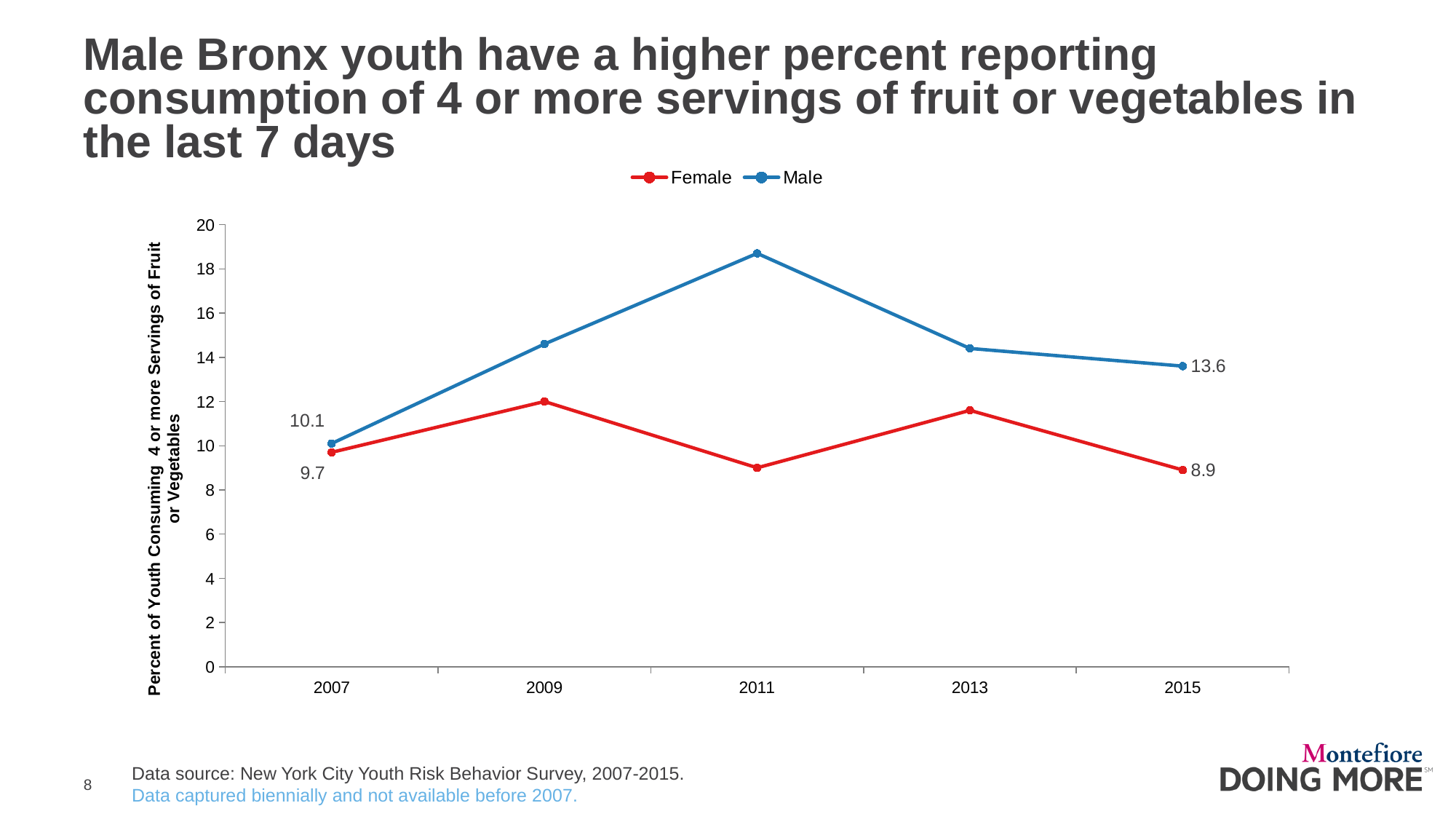
Is the value for Male in 2011 greater or less than 16? greater What is the value for Male in 2015? 13.6 How many years are plotted on the x axis? 5 What is the value for Female in 2015? 8.9 What is the value for Male in 2007? 10.1 In which year does the Male series reach its highest value? 2011 In 2015, which series has the larger value, Male or Female? Male How many series does the legend list? 2 What is the difference between the Male and Female values in 2015? 4.7 What is the difference between the Male and Female values in 2007? 0.4 What is the value for Female in 2007? 9.7 Is the value for Female in 2011 greater or less than 10? less